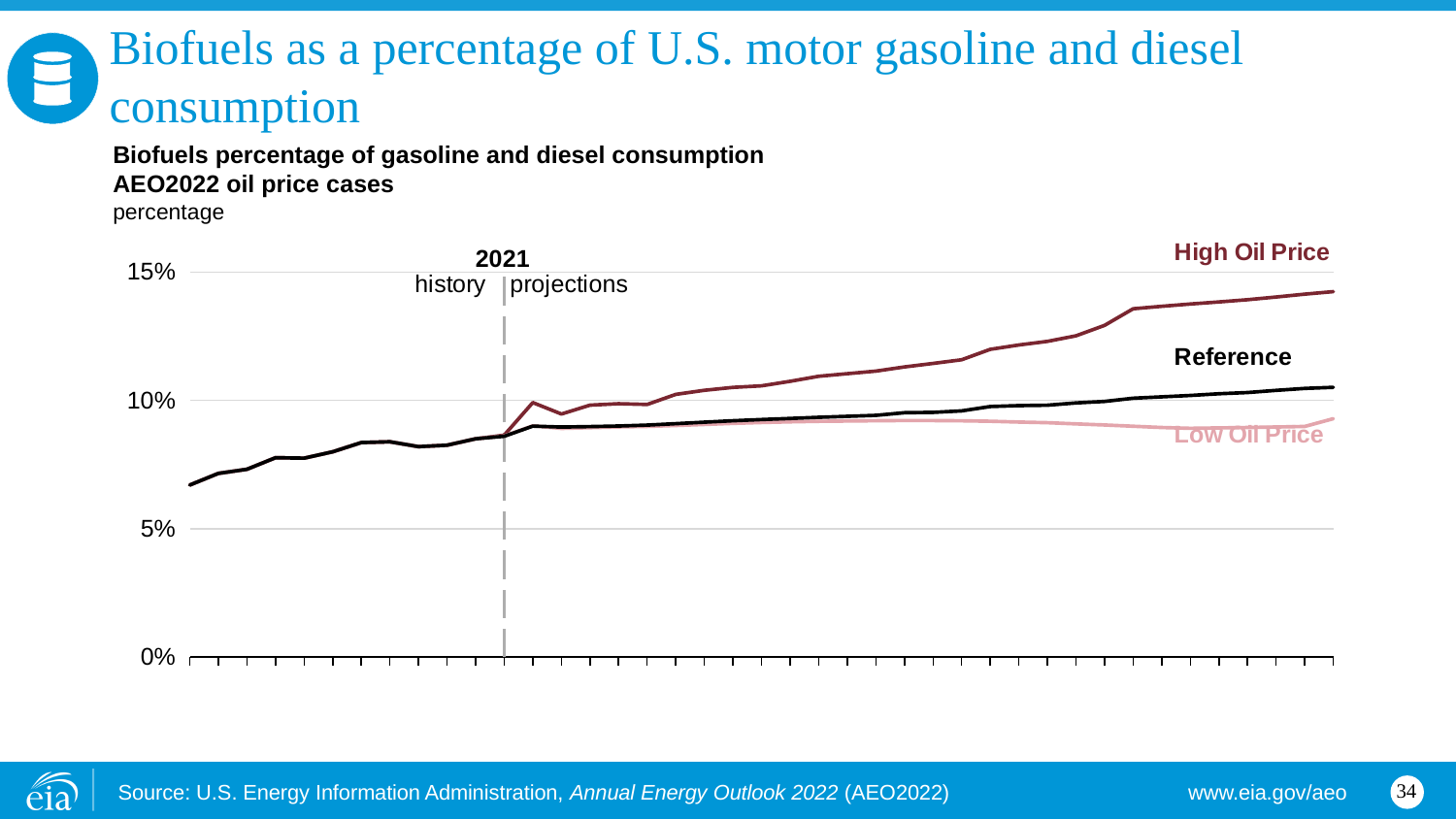
What is the unit shown on the vertical axis of the chart? percentage Which series has the highest value at the right end of the projection period? High Oil Price At the start of the history period, is the biofuels percentage greater or less than 5%? greater What kind of chart is shown on the slide? line chart How many oil price cases (series) are plotted on the chart? 3 Does the High Oil Price series rise or fall over the projection period? rise At the right end of the chart, is the value for High Oil Price greater or less than 10%? greater Which series has the lowest value at the right end of the projection period? Low Oil Price At the right end of the chart, is the value for Low Oil Price greater or less than 10%? less At the right end of the chart, which is larger: the High Oil Price value or the Reference value? High Oil Price Which year separates history from projections on the chart? 2021